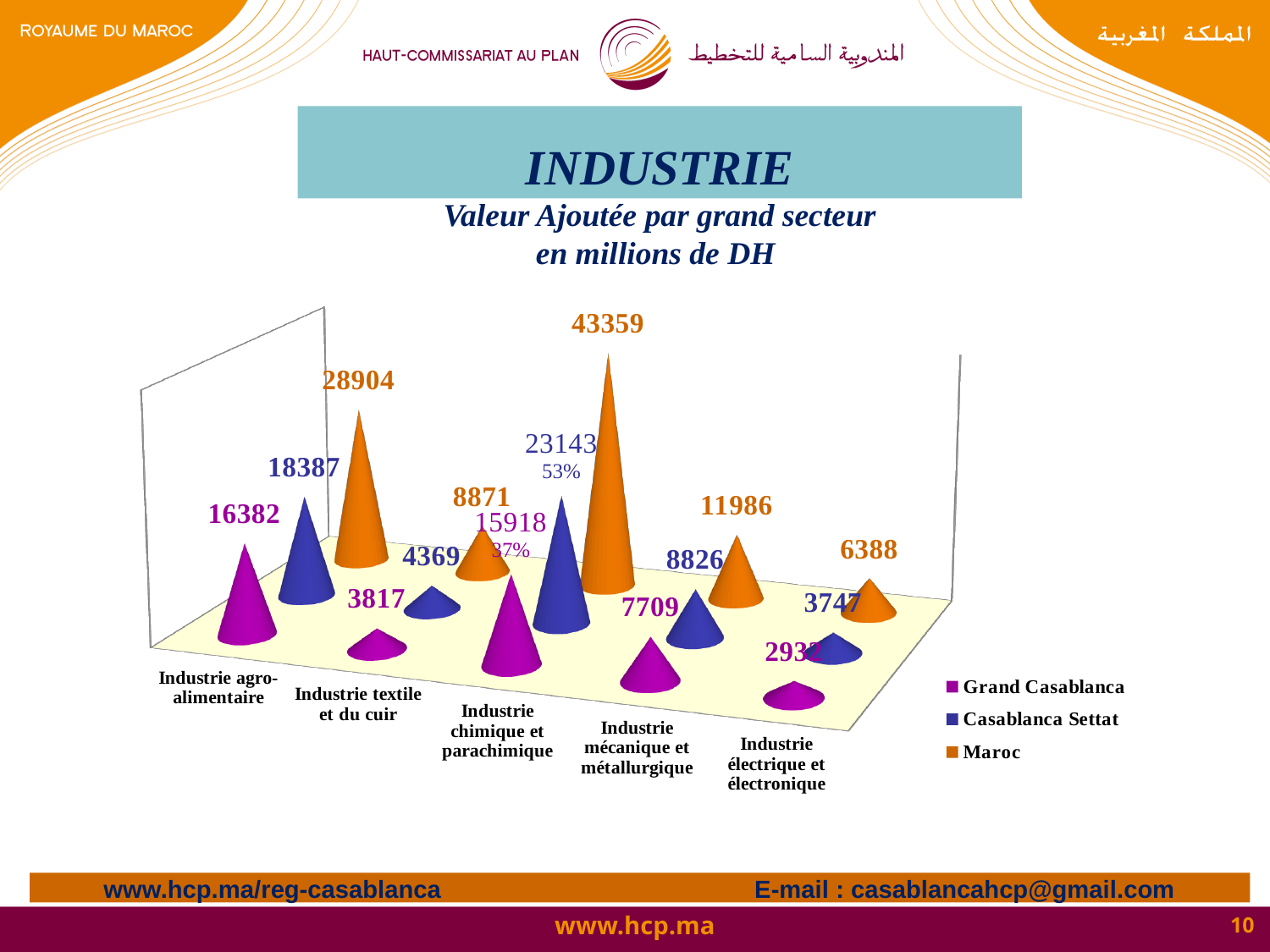
How many series does the legend list? 3 What kind of chart is shown on the slide? bar chart Which sector has the highest Maroc value? Industrie chimique et parachimique What is the Maroc value for Industrie chimique et parachimique? 43359 What is the Casablanca Settat value for Industrie agro-alimentaire? 18387 What is the Grand Casablanca value for Industrie textile et du cuir? 3817 What is the difference between the Maroc value and the Casablanca Settat value for Industrie agro-alimentaire? 10517 Which sector has the lowest Maroc value? Industrie électrique et électronique What is the Maroc value for Industrie mécanique et métallurgique? 11986 For Casablanca Settat, which is larger: Industrie agro-alimentaire or Industrie chimique et parachimique? Industrie chimique et parachimique What is the difference between the Maroc value and the Casablanca Settat value for Industrie textile et du cuir? 4502 How many industrial sectors are shown on the x axis? 5